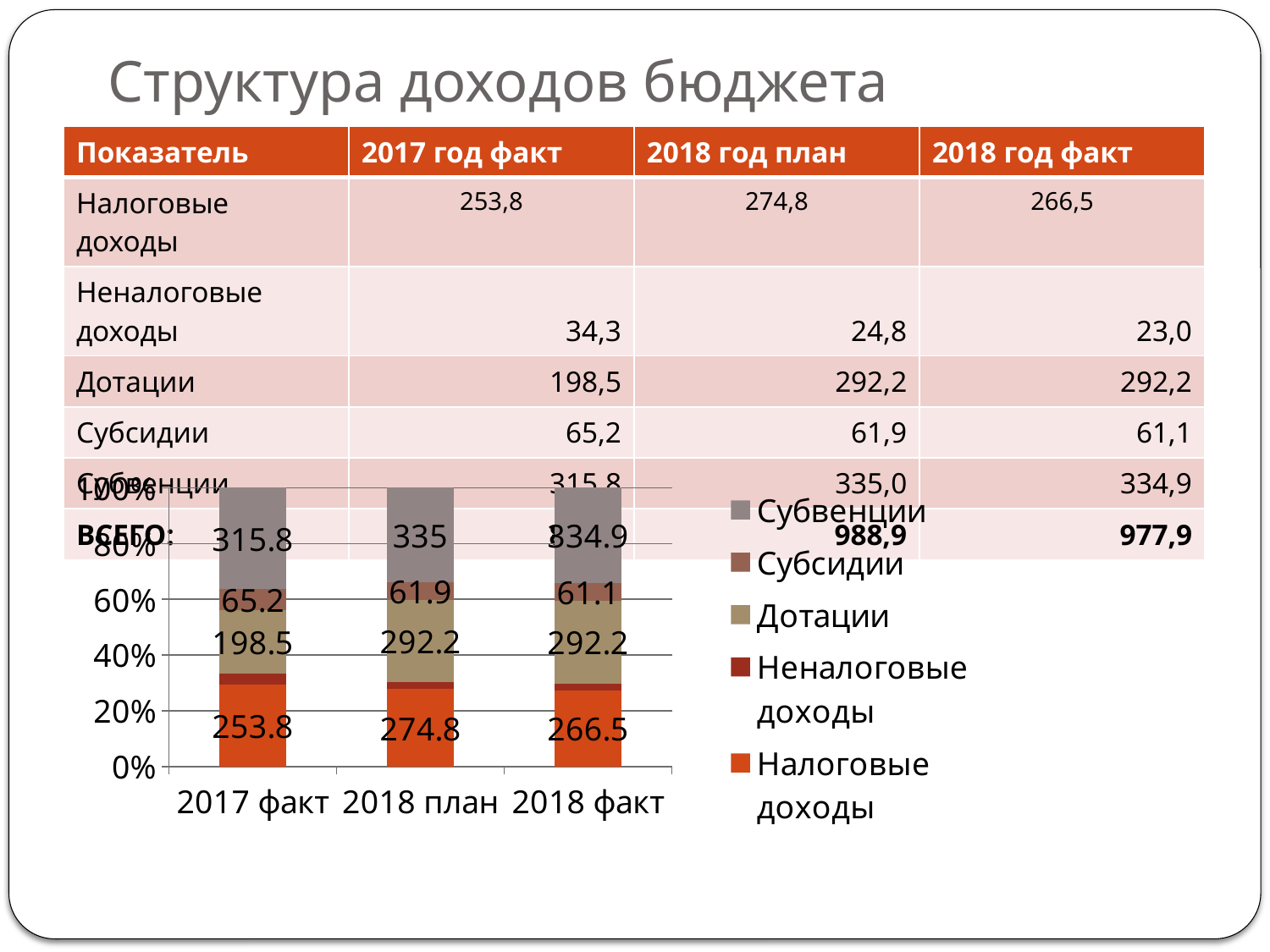
Which series is shown at the top of each stacked bar in the chart? Субвенции What is the value of Субвенции for 2017 факт in the chart? 315.8 How many series does the chart legend list? 5 What is the value of Субсидии for 2018 план in the chart? 61.9 How many categories are shown on the x axis of the chart? 3 Which category has the highest value for Субвенции in the chart? 2018 план Which category has the lowest value for Дотации in the chart? 2017 факт Which is larger in the chart: Налоговые доходы for 2018 план or for 2018 факт? 2018 план What is the difference between the Дотации values for 2018 план and 2017 факт in the chart? 93.7 What is the value of Дотации for 2018 факт in the chart? 292.2 What is the value of Налоговые доходы for 2018 план in the chart? 274.8 What kind of chart is shown on the slide? stacked bar chart